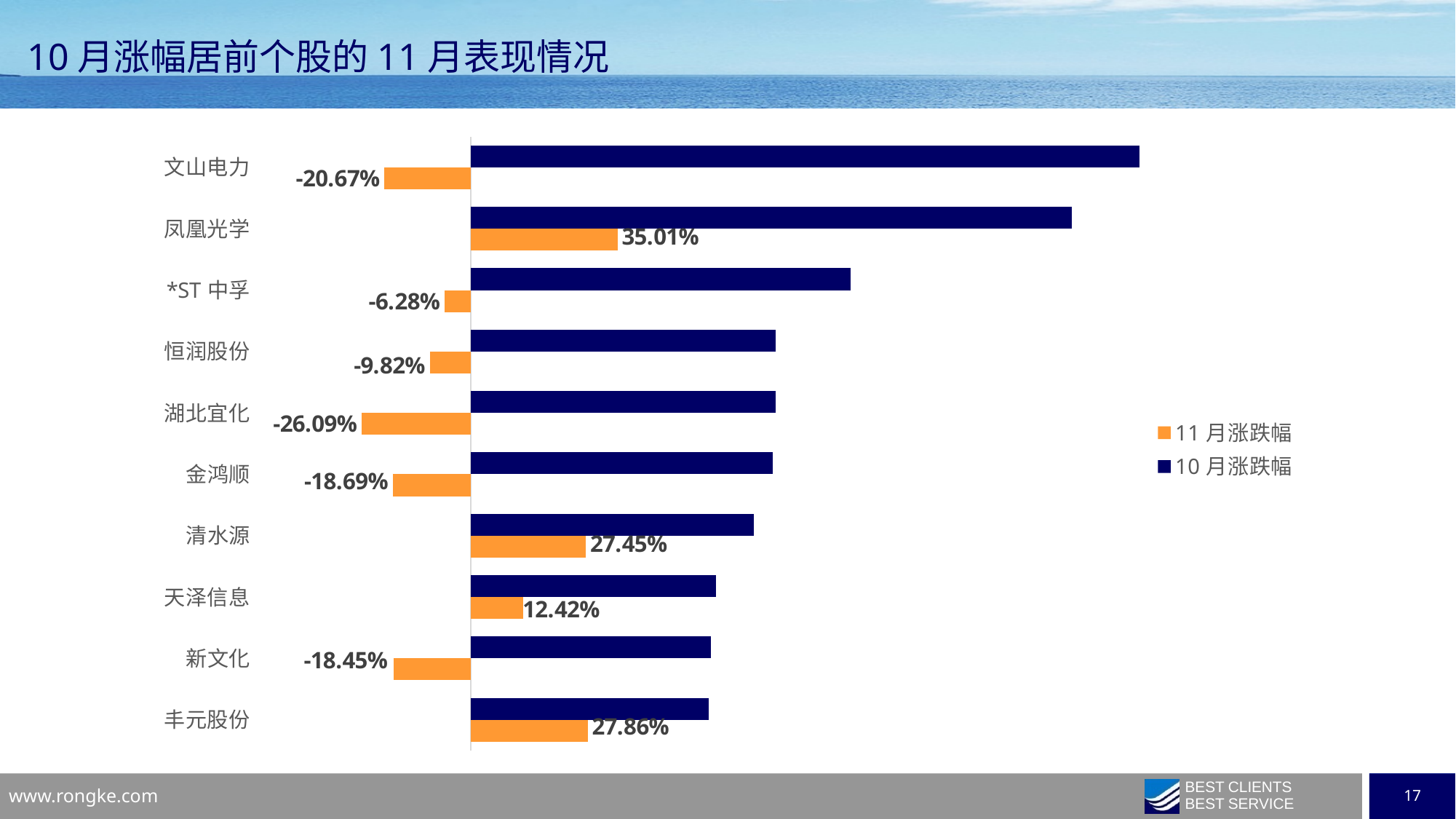
How many series does the legend list? 2 What is the 11月涨跌幅 value for 凤凰光学? 35.01% Which stock has the highest 10月涨跌幅? 文山电力 What is the 11月涨跌幅 value for 湖北宜化? -26.09% How many stocks (categories) are listed on the chart? 10 Which stock has the highest 11月涨跌幅? 凤凰光学 What is the 11月涨跌幅 value for 新文化? -18.45% What is the difference between the 11月涨跌幅 of 凤凰光学 and 丰元股份? 7.15 percentage points Which colour represents 11月涨跌幅 in the legend? orange What kind of chart is shown on the slide? bar chart Which stock has the lowest 11月涨跌幅? 湖北宜化 What is the 11月涨跌幅 value for 天泽信息? 12.42%